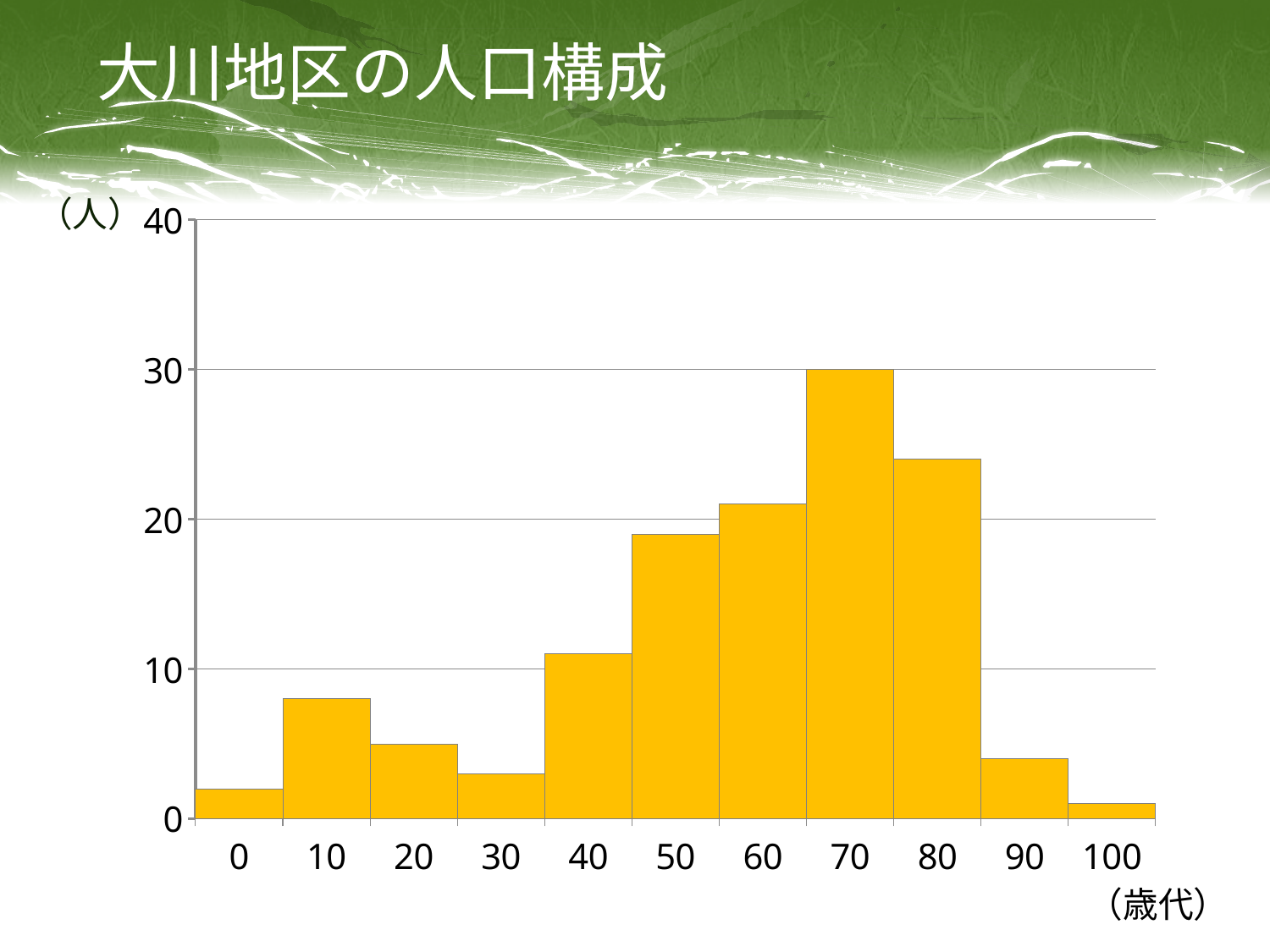
Which age group (歳代) has the highest value? 70 Do the values rise or fall from the 70 age group to the 100 age group? fall Is the value for the 40 age group greater or less than 10? greater How many age-group bars are plotted in the chart? 11 Which has the larger value, the 70 age group or the 80 age group? 70 Is the value for the 80 age group greater or less than 20? greater What type of chart is shown on the slide? bar chart Which has the larger value, the 30 age group or the 40 age group? 40 What is the value for the 70 age group? 30 Is the value for the 90 age group greater or less than 10? less What is the title of the chart? 大川地区の人口構成